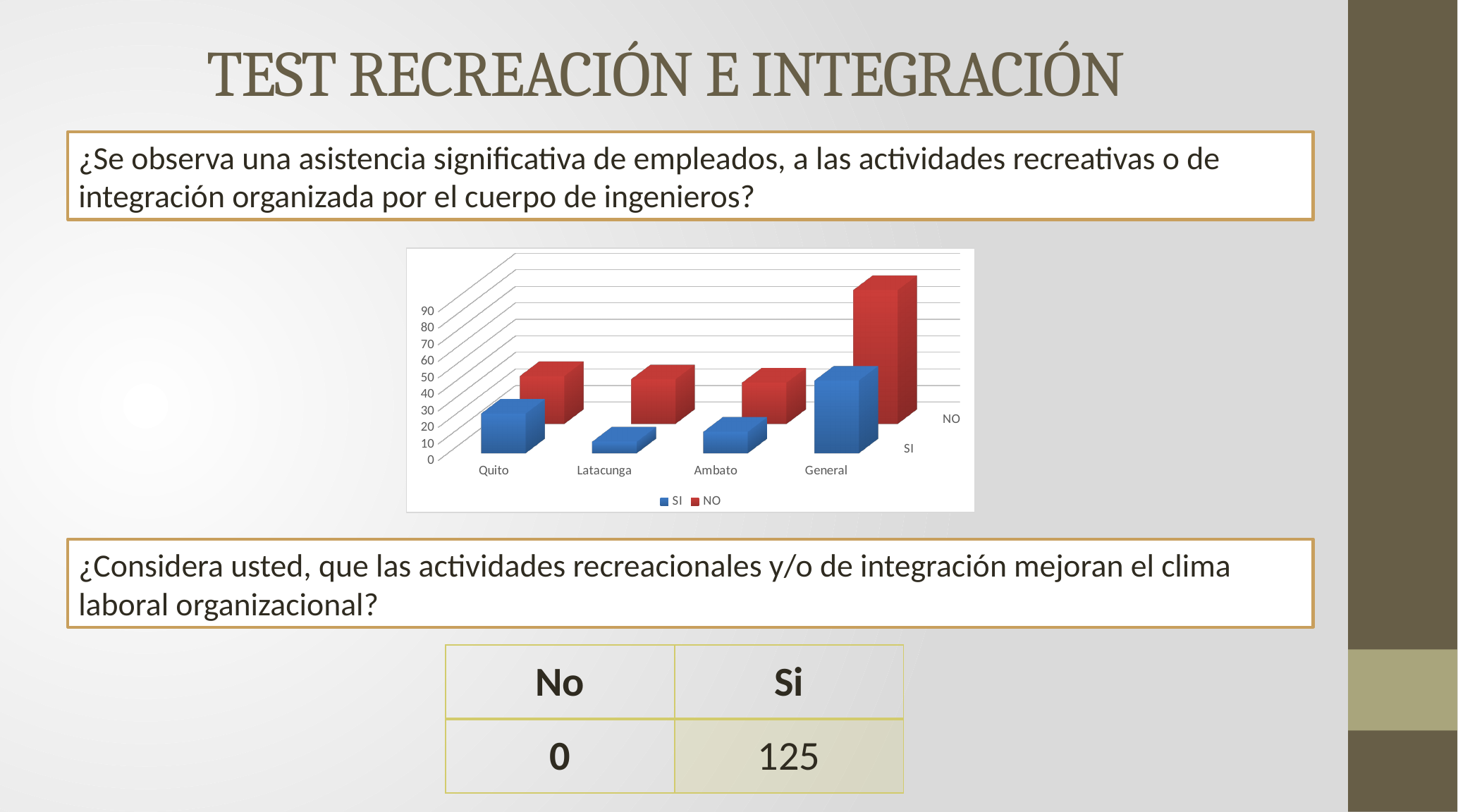
How many categories are shown on the x axis of the chart? 4 Is the NO value for General greater or less than 50? greater What kind of chart is shown on the slide? bar chart Which category has the highest NO value in the chart? General Which category has the lowest SI value in the chart? Latacunga Which is larger in the chart: the NO value for General or the NO value for Quito? General How many series does the chart's legend list? 2 What colour represents the NO series in the chart? red Is the SI value for Latacunga greater or less than 20? less Is the SI value for Quito greater or less than 40? less Which category has the highest SI value in the chart? General Which is larger in the chart: the SI value for General or the SI value for Ambato? General